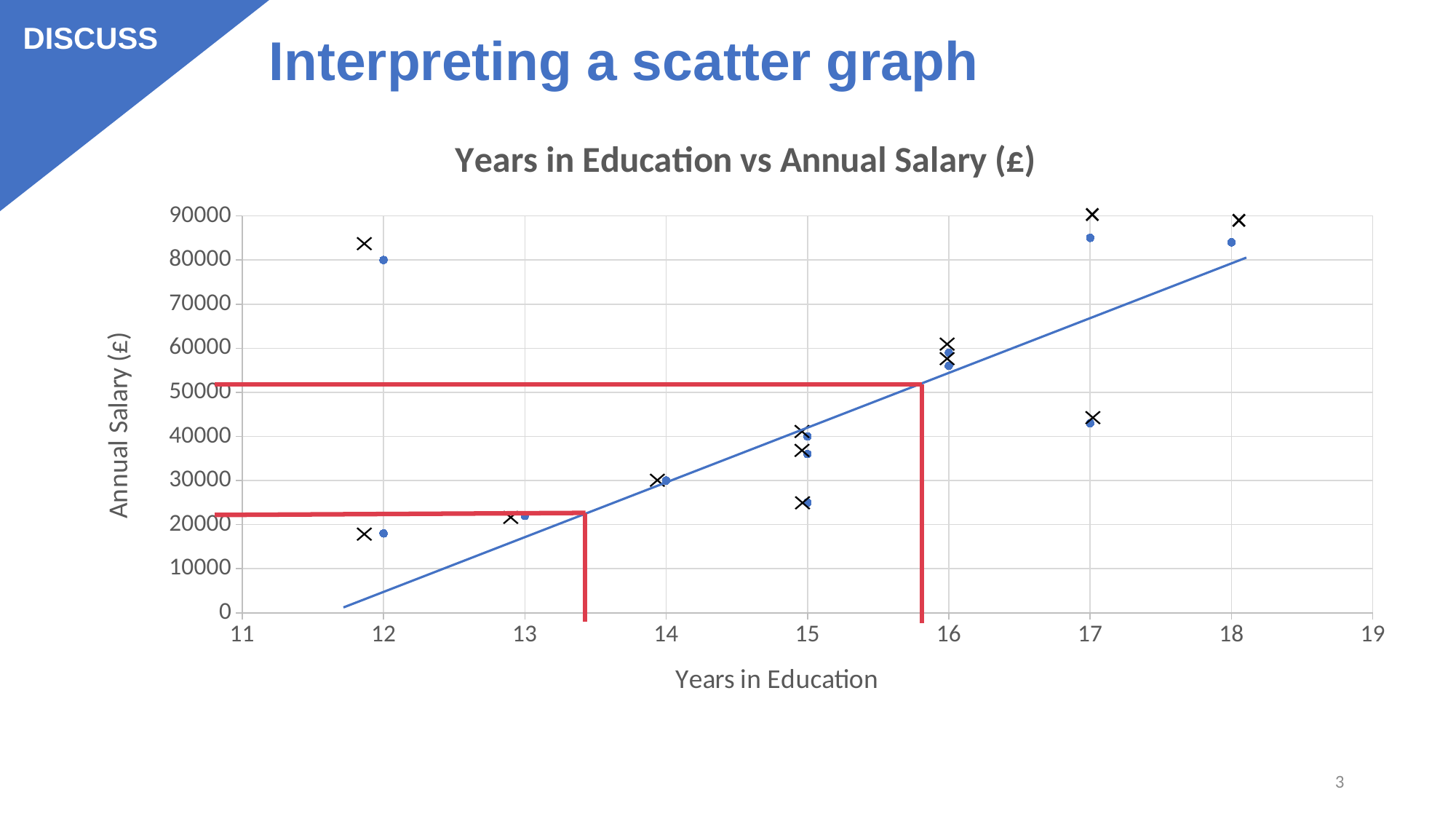
Is the annual salary for the point at 14 years in education greater or less than 40000? less Is the annual salary for the higher of the two points at 12 years in education greater or less than 70000? greater Is the annual salary for the point at 18 years in education greater or less than 80000? greater What kind of chart is shown on the slide? Scatter graph What is the title of the chart? Years in Education vs Annual Salary (£) What is the label on the vertical axis of the chart? Annual Salary (£) What is the highest value shown on the vertical axis? 90000 How many data points are plotted on the scatter graph? 12 Does the trend line show annual salary rising or falling as years in education increase? Rising